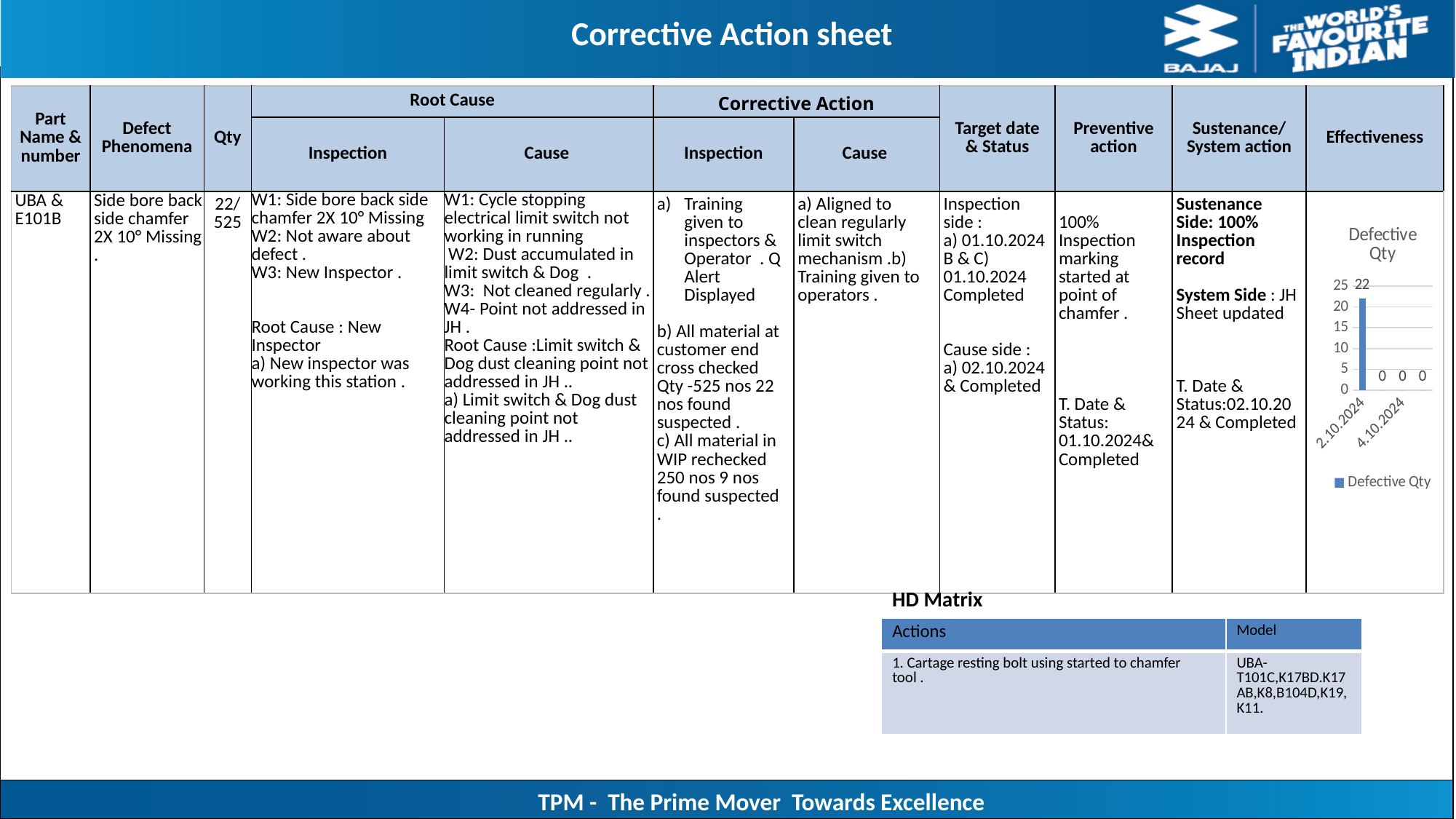
What is the highest tick value on the vertical axis of the Defective Qty chart? 25 What is the lowest value shown in the Defective Qty chart? 0 What kind of chart is the Defective Qty chart on the right of the slide? bar chart How many series does the legend of the Defective Qty chart list? 1 How many data points in the Defective Qty chart have a value of 0? 3 What is the highest value shown in the Defective Qty chart? 22 Is the highest value in the Defective Qty chart greater or less than 20? greater Do the values in the Defective Qty chart rise or fall along the x axis? fall How many data points are plotted in the Defective Qty chart? 4 What is the difference between the highest and lowest values in the Defective Qty chart? 22 What is the title of the chart on the slide? Defective Qty